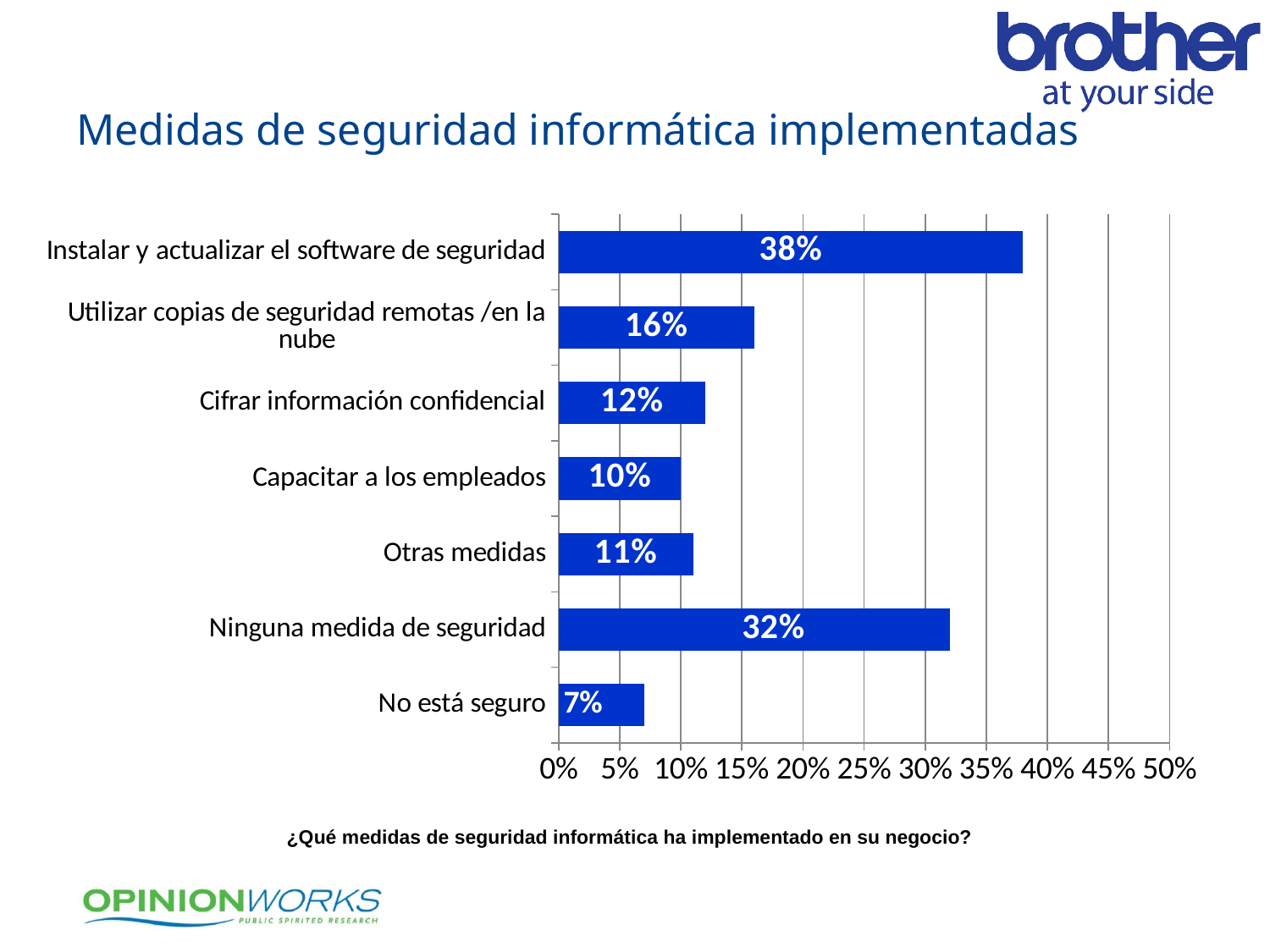
What is the value for "Cifrar información confidencial"? 12% Which category has the lowest value? No está seguro What is the value for "No está seguro"? 7% Which is larger, "Otras medidas" or "Capacitar a los empleados"? Otras medidas Which category has the highest value? Instalar y actualizar el software de seguridad Is the value for "Utilizar copias de seguridad remotas /en la nube" greater or less than 20%? less How many categories are shown in the chart? 7 What is the difference between "Utilizar copias de seguridad remotas /en la nube" and "Capacitar a los empleados"? 6% What is the value for "Instalar y actualizar el software de seguridad"? 38% What is the difference between "Instalar y actualizar el software de seguridad" and "Ninguna medida de seguridad"? 6% What kind of chart is shown on the slide? bar chart What is the value for "Ninguna medida de seguridad"? 32%